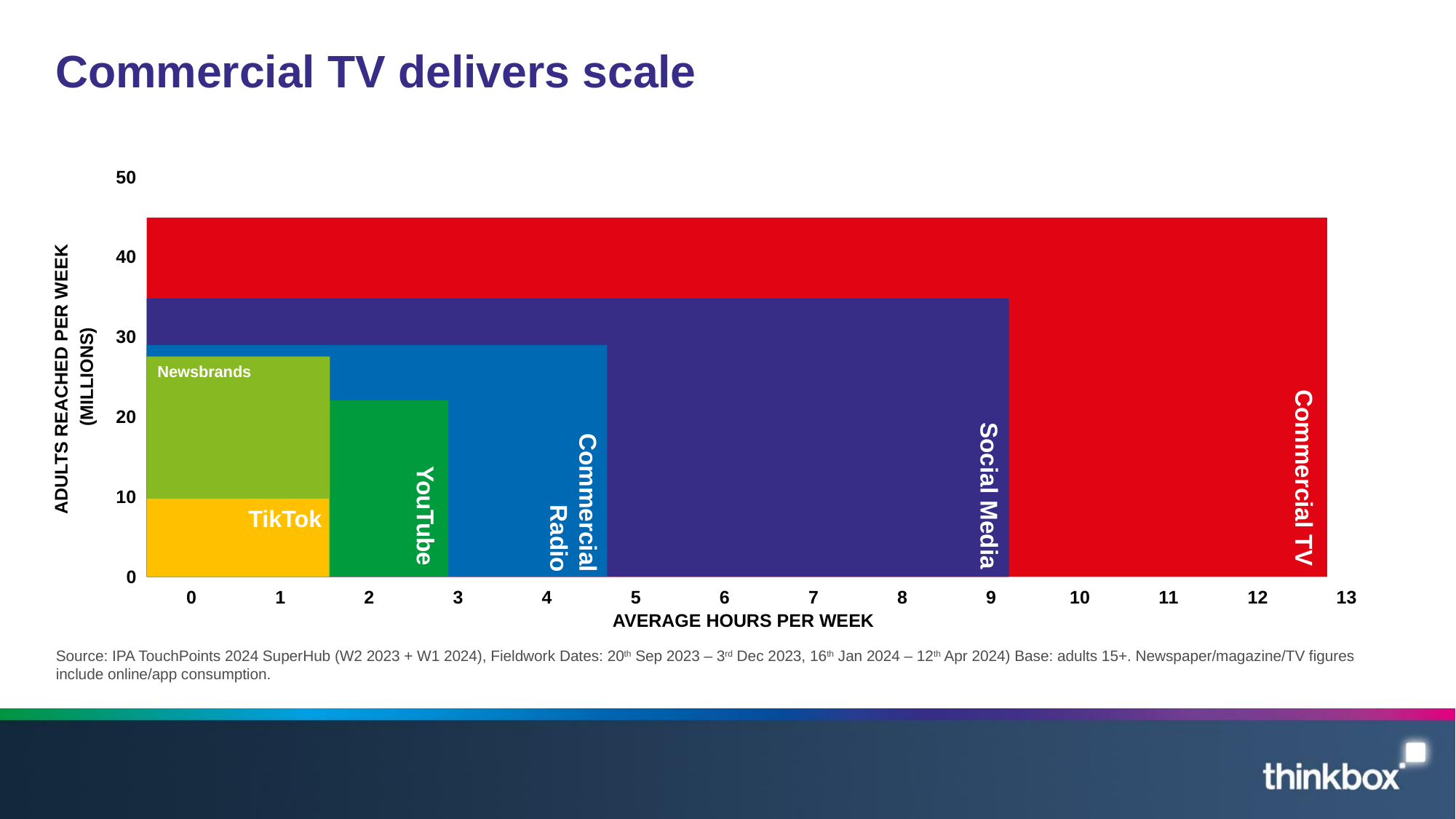
Is the number of adults reached per week by Commercial TV greater or less than 40 million? greater Is the number of adults reached per week by TikTok greater or less than 20 million? less Which media category reaches the most adults per week? Commercial TV What kind of chart is shown on the slide? bar chart What is the title of the chart on the slide? Commercial TV delivers scale Which media category reaches the fewest adults per week? TikTok Which reaches more adults per week, Social Media or Commercial Radio? Social Media Is the number of adults reached per week by Social Media greater or less than 30 million? greater What is the label on the vertical axis of the chart? ADULTS REACHED PER WEEK (MILLIONS) Which media category has the highest average hours per week? Commercial TV How many media categories are shown in the chart? 6